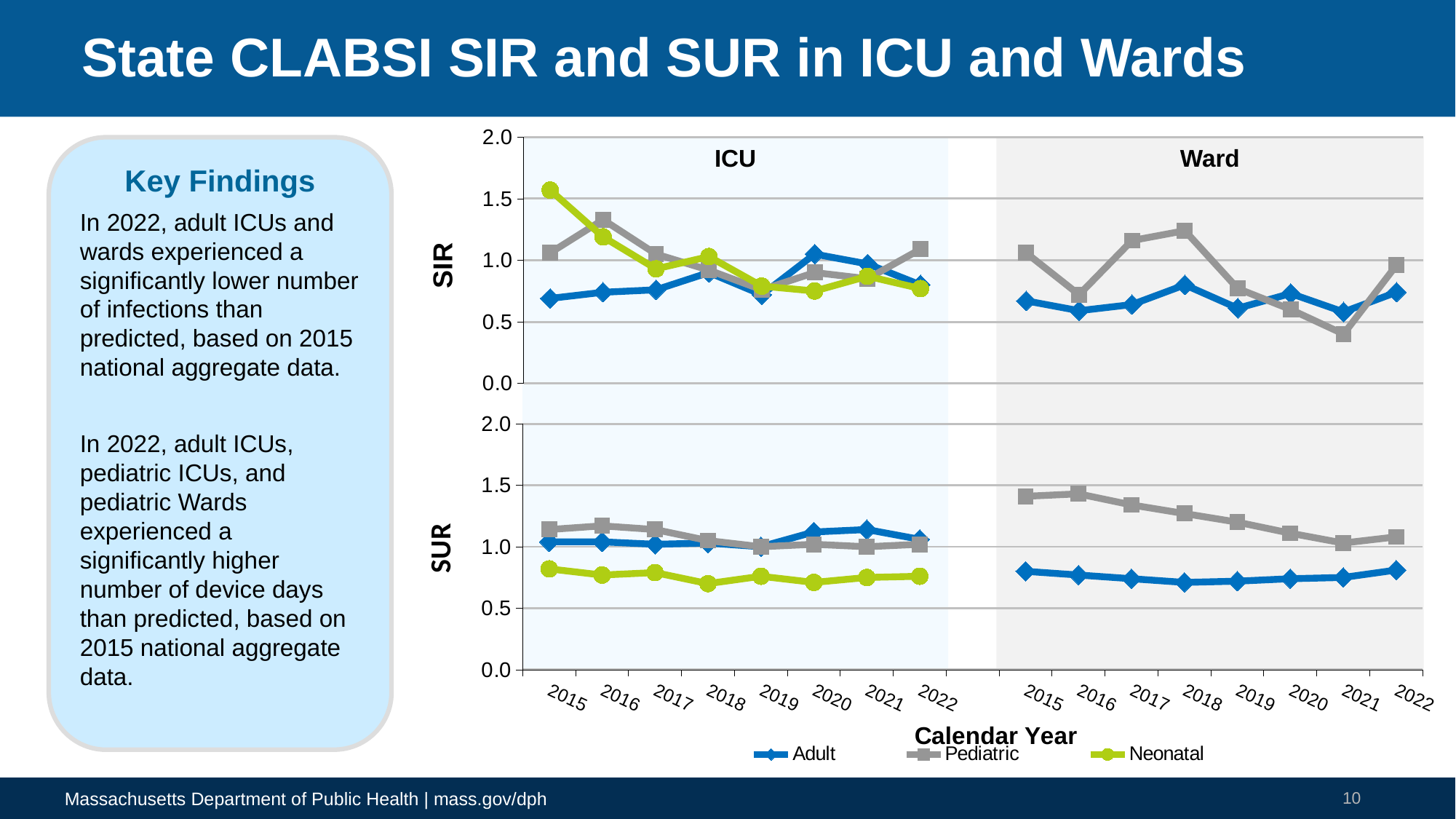
In the SIR panel, ICU section, which series has the highest value in 2015? Neonatal In the SIR panel, ICU section, is the Adult value for 2015 greater or less than 1.0? less In the SIR panel, Ward section, in which year is the Pediatric value lowest? 2021 In the SIR panel, Ward section, is the Pediatric value for 2021 greater or less than 0.5? less In the SUR panel, ICU section, is the Neonatal value for 2018 greater or less than 1.0? less What kind of chart is shown on the slide? line chart How many calendar years are plotted on the x axis of the ICU section? 8 In the SUR panel, Ward section, does the Pediatric series generally rise or fall from 2015 to 2022? fall How many series does the legend list? 3 In the SUR panel, Ward section, which is larger in 2015: the Adult value or the Pediatric value? Pediatric